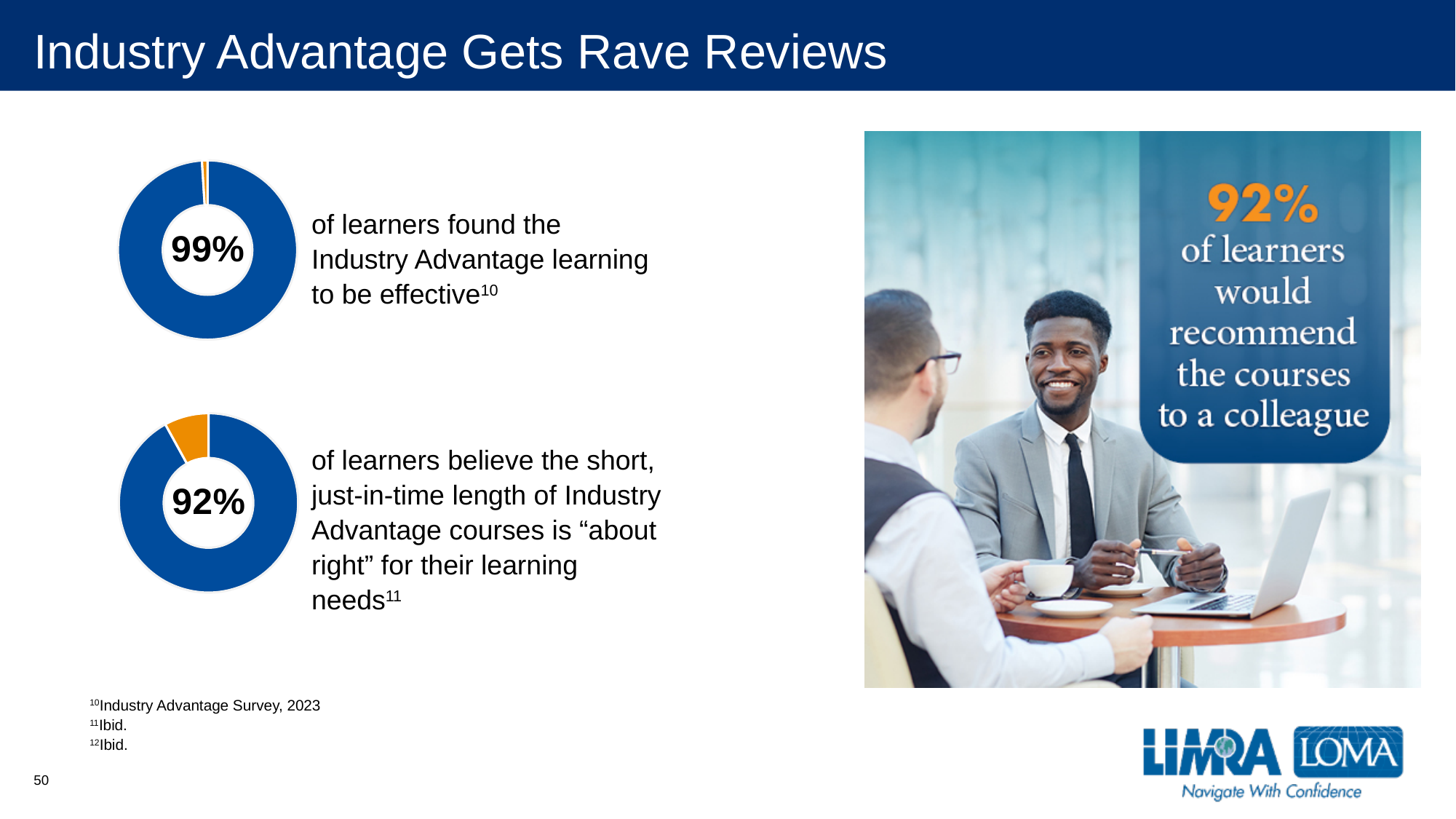
How many donut charts are on the slide? 2 Which of the two donut charts shows the larger percentage, the top one or the bottom one? the top one Is the blue slice in the bottom donut chart larger or smaller than the orange slice? larger What kind of chart is used to show the 99% figure? donut (pie) chart In the top donut chart, what colour is the small slice that is not part of the 99%? orange How many slices does the bottom donut chart have? 2 What percentage is shown in the centre of the bottom donut chart? 92% What percentage is shown in the centre of the top donut chart? 99% In the bottom donut chart, what colour is the slice representing the 92%? blue According to the bottom chart, what share of learners believe the just-in-time length of Industry Advantage courses is "about right"? 92% According to the top chart, what share of learners found the Industry Advantage learning to be effective? 99% What is the difference between the percentage in the top chart and the percentage in the bottom chart? 7 percentage points